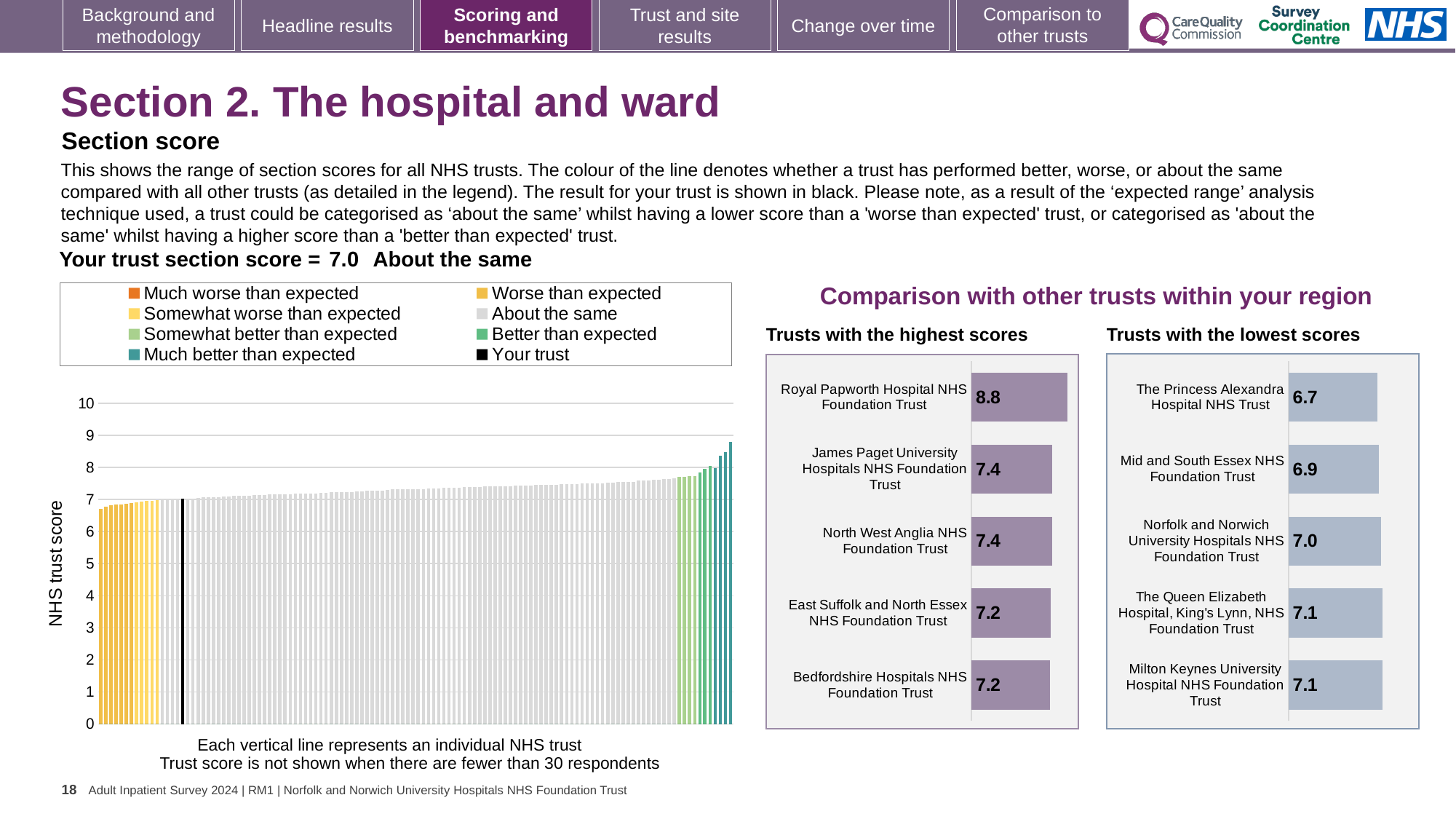
Which has the higher score: Bedfordshire Hospitals NHS Foundation Trust in the 'highest scores' chart or Mid and South Essex NHS Foundation Trust in the 'lowest scores' chart? Bedfordshire Hospitals NHS Foundation Trust In the 'Trusts with the lowest scores' chart, what is the score for The Princess Alexandra Hospital NHS Trust? 6.7 In the 'Trusts with the highest scores' chart, what is the difference between the scores of Royal Papworth Hospital NHS Foundation Trust and James Paget University Hospitals NHS Foundation Trust? 1.4 How many trusts are shown in the 'Trusts with the highest scores' chart? 5 In the 'Trusts with the lowest scores' chart, which trust has the lowest score? The Princess Alexandra Hospital NHS Trust How many entries does the legend of the large chart on the left list? 8 In the 'Trusts with the lowest scores' chart, what is the difference between the scores of Norfolk and Norwich University Hospitals NHS Foundation Trust and The Princess Alexandra Hospital NHS Trust? 0.3 In the 'Trusts with the highest scores' chart, what is the score for Royal Papworth Hospital NHS Foundation Trust? 8.8 In the large chart on the left showing all NHS trusts, is the tallest bar greater or less than 8? greater What kind of chart is the 'Trusts with the lowest scores' chart? Bar chart In the 'Trusts with the highest scores' chart, which trust has the highest score? Royal Papworth Hospital NHS Foundation Trust In the 'Trusts with the lowest scores' chart, what is the score for Norfolk and Norwich University Hospitals NHS Foundation Trust? 7.0